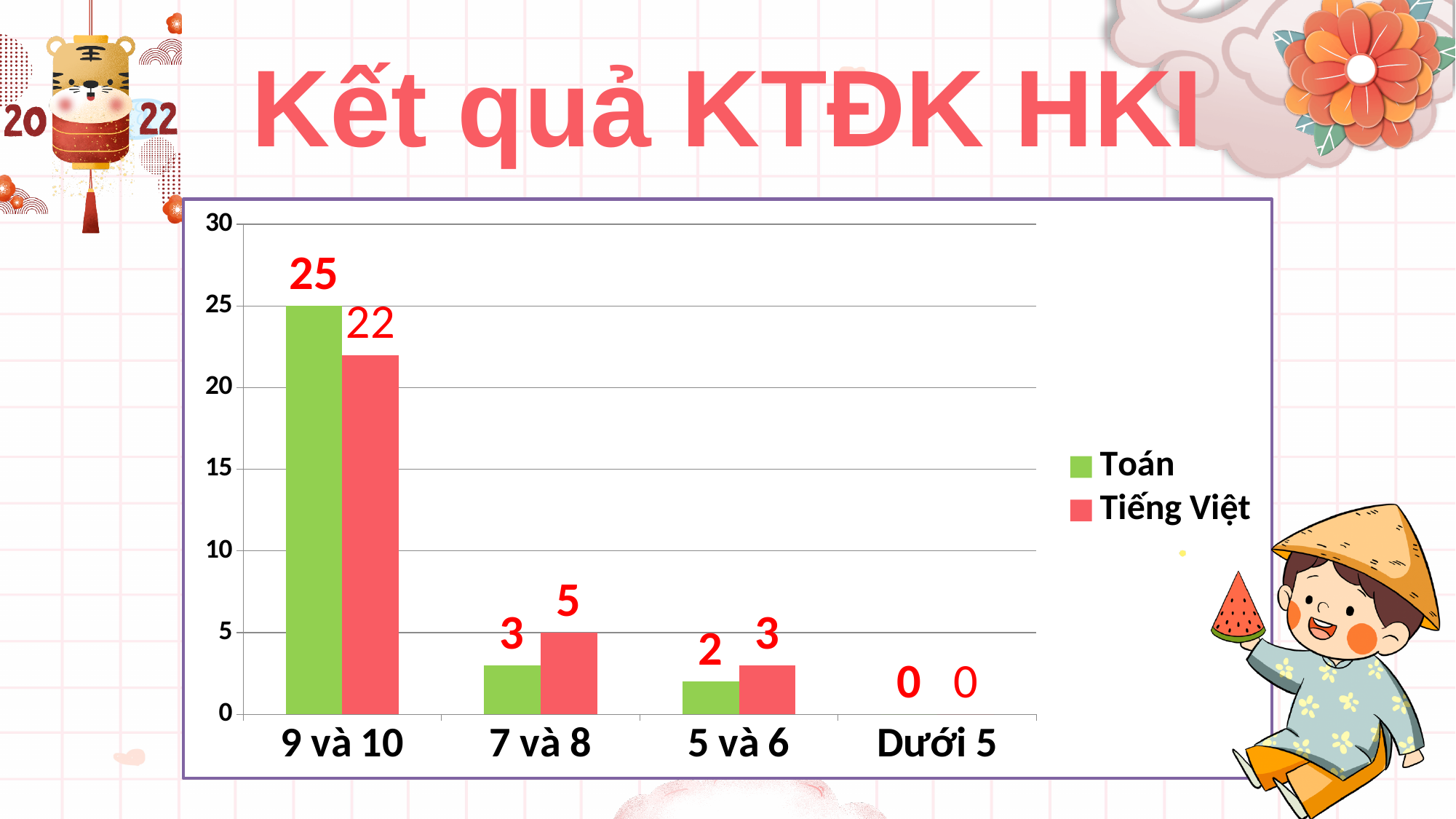
In the 7 và 8 category, which series has the larger value, Toán or Tiếng Việt? Tiếng Việt What is the value for Tiếng Việt in the 7 và 8 category? 5 Which category has the highest value for Toán? 9 và 10 What kind of chart is shown on the slide? Bar chart Which category has the lowest value for Tiếng Việt? Dưới 5 How many series does the legend list? 2 How many categories are shown on the x axis? 4 What is the value for Toán in the 5 và 6 category? 2 What colour represents the Toán series in the legend? Green What is the value for Tiếng Việt in the 9 và 10 category? 22 What is the difference between the Toán and Tiếng Việt values in the 9 và 10 category? 3 What is the value for Toán in the 9 và 10 category? 25